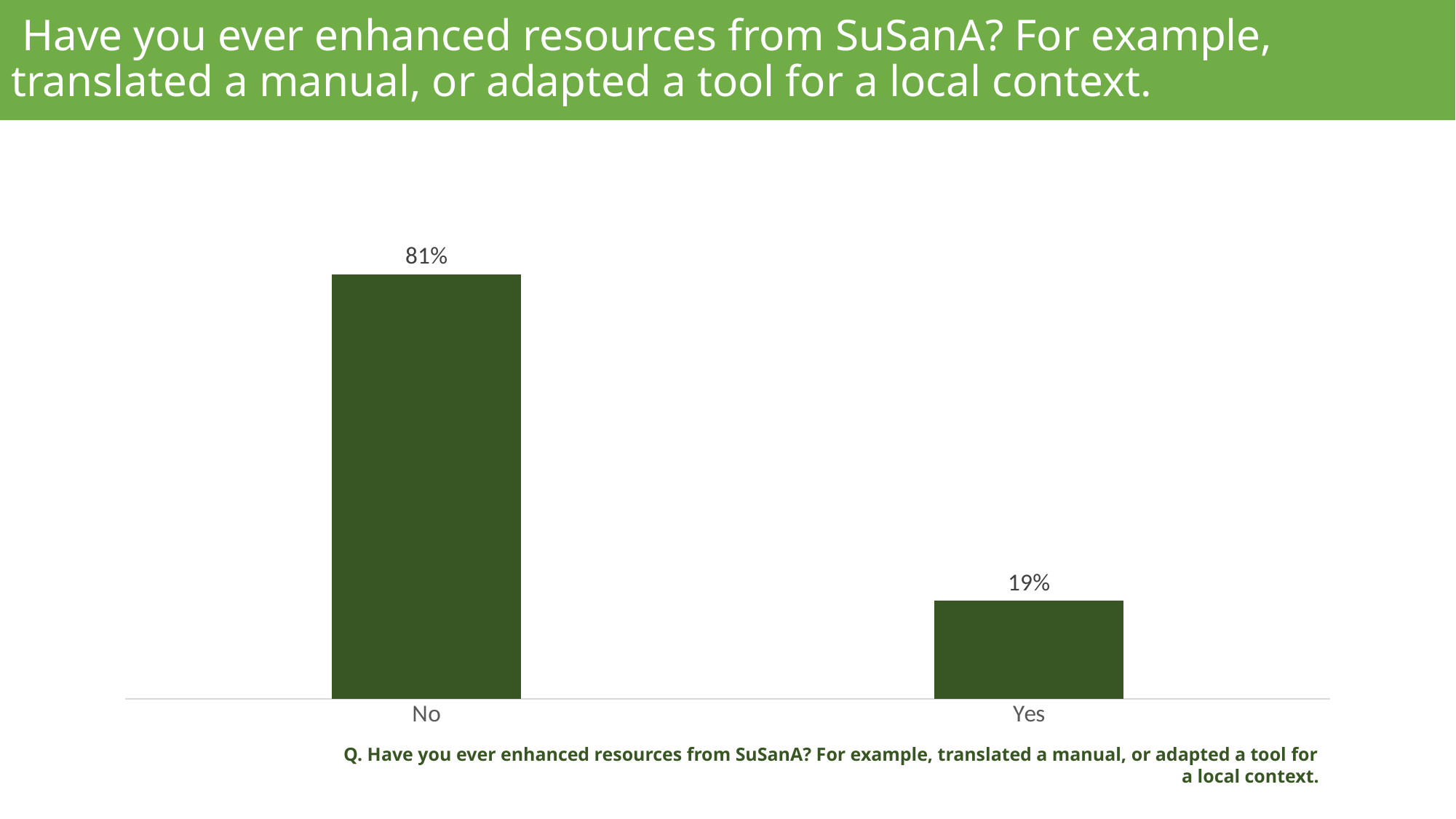
What is the total of the two percentages shown on the chart? 100% Which is larger, the value for "No" or the value for "Yes"? No What colour are the bars in the chart? Dark green Which response category has the lowest value? Yes What question does the chart's footnote say the data is based on? Have you ever enhanced resources from SuSanA? For example, translated a manual, or adapted a tool for a local context. What is the difference in percentage points between the "No" and "Yes" responses? 62 percentage points What percentage of respondents answered "No"? 81% What percentage of respondents answered "Yes"? 19% What type of chart is shown on the slide? Bar chart How many response categories are shown on the chart? 2 Which response category has the highest value? No